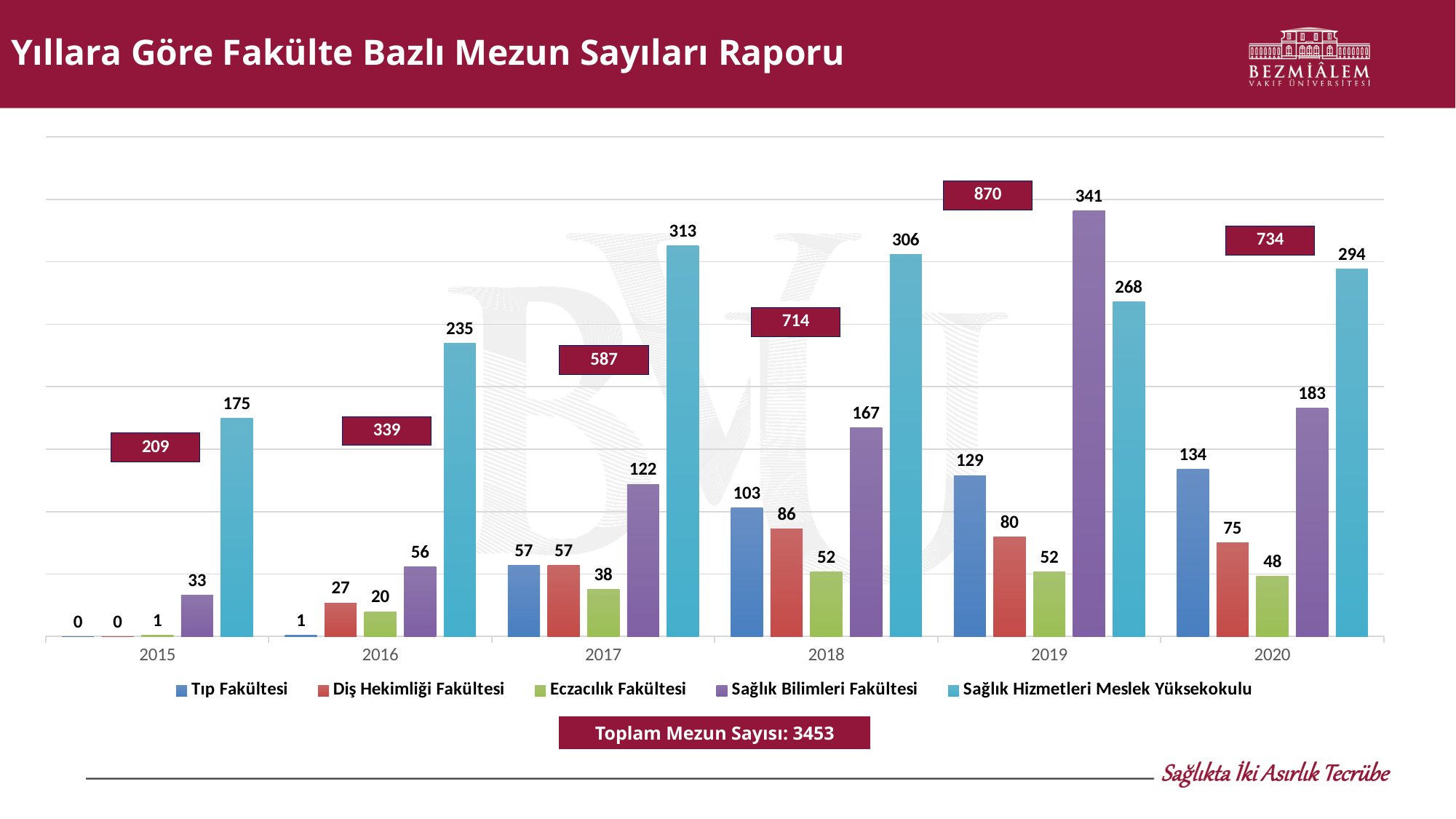
Which is larger in 2018: Diş Hekimliği Fakültesi or Tıp Fakültesi? Tıp Fakültesi How many series does the legend list? 5 Do the values for Tıp Fakültesi rise or fall from 2015 to 2020? Rise What is the total number of graduates shown in the box below the legend (Toplam Mezun Sayısı)? 3453 What is the value for Sağlık Hizmetleri Meslek Yüksekokulu in 2017? 313 How many years are shown on the x axis? 6 Which series has the lowest value in 2018? Eczacılık Fakültesi What kind of chart is shown on the slide? Bar chart Which year has the highest value for Sağlık Bilimleri Fakültesi? 2019 What is the value for Tıp Fakültesi in 2019? 129 What is the value for Sağlık Bilimleri Fakültesi in 2020? 183 What is the difference between the Sağlık Hizmetleri Meslek Yüksekokulu values in 2019 and 2020? 26